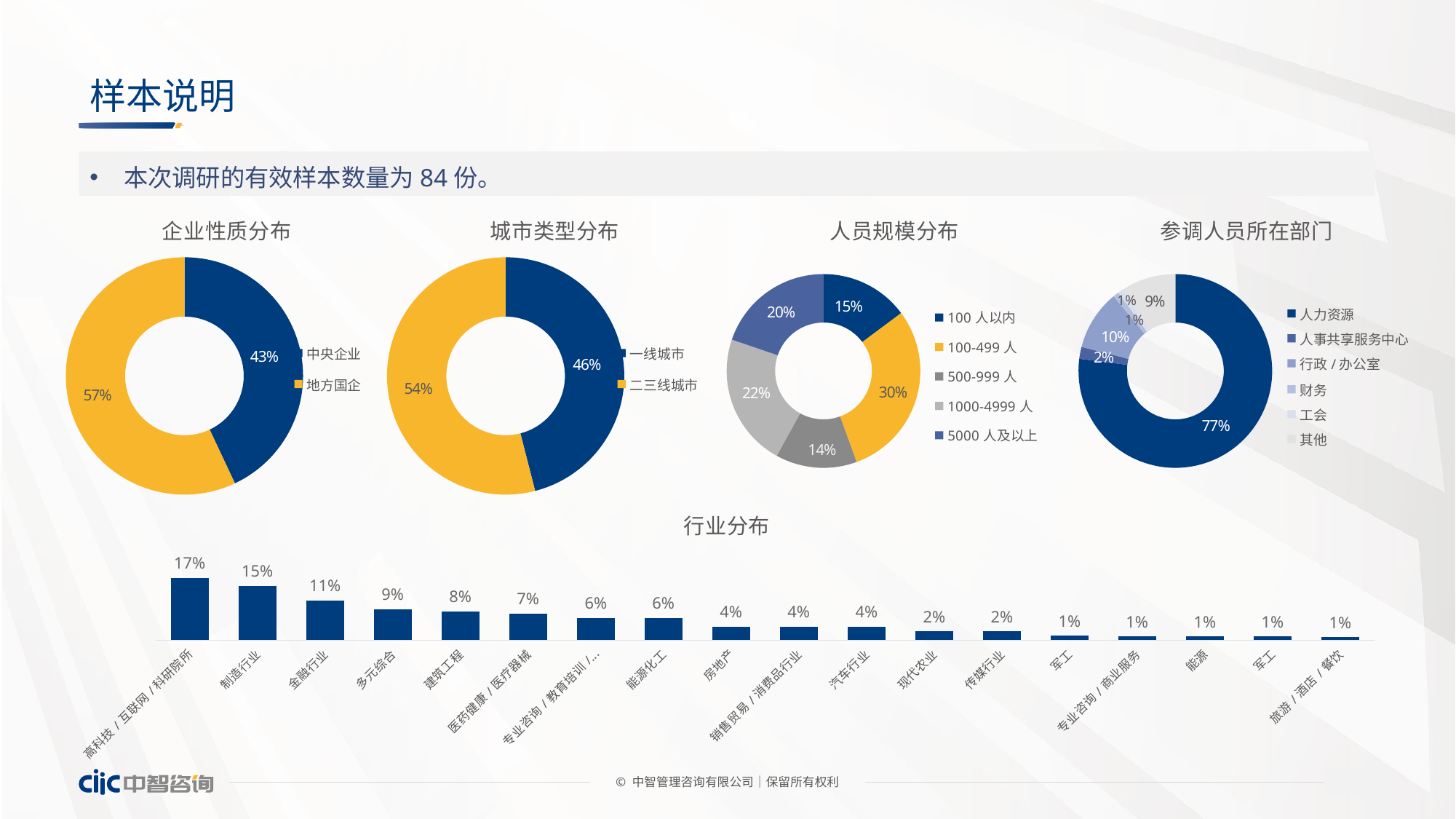
In the 参调人员所在部门 chart, how many categories does the legend list? 6 In the 人员规模分布 chart, what is the difference between the shares of 100-499 人 and 500-999 人? 16% In the 行业分布 chart, which industry has the highest share? 高科技 / 互联网 / 科研院所 In the 行业分布 chart, what is the difference between 制造行业 and 建筑工程? 7% In the 参调人员所在部门 chart, what share is 人力资源? 77% In the 城市类型分布 chart, what share is 二三线城市? 54% In the 人员规模分布 chart, what is the share for 1000-4999 人? 22% In the 行业分布 chart, what is the value for 金融行业? 11% What kind of chart is the 行业分布 chart? bar chart In the 人员规模分布 chart, which category has the largest share? 100-499 人 In the 企业性质分布 chart, what share is 中央企业? 43% In the 参调人员所在部门 chart, which is larger, 行政 / 办公室 or 其他? 行政 / 办公室